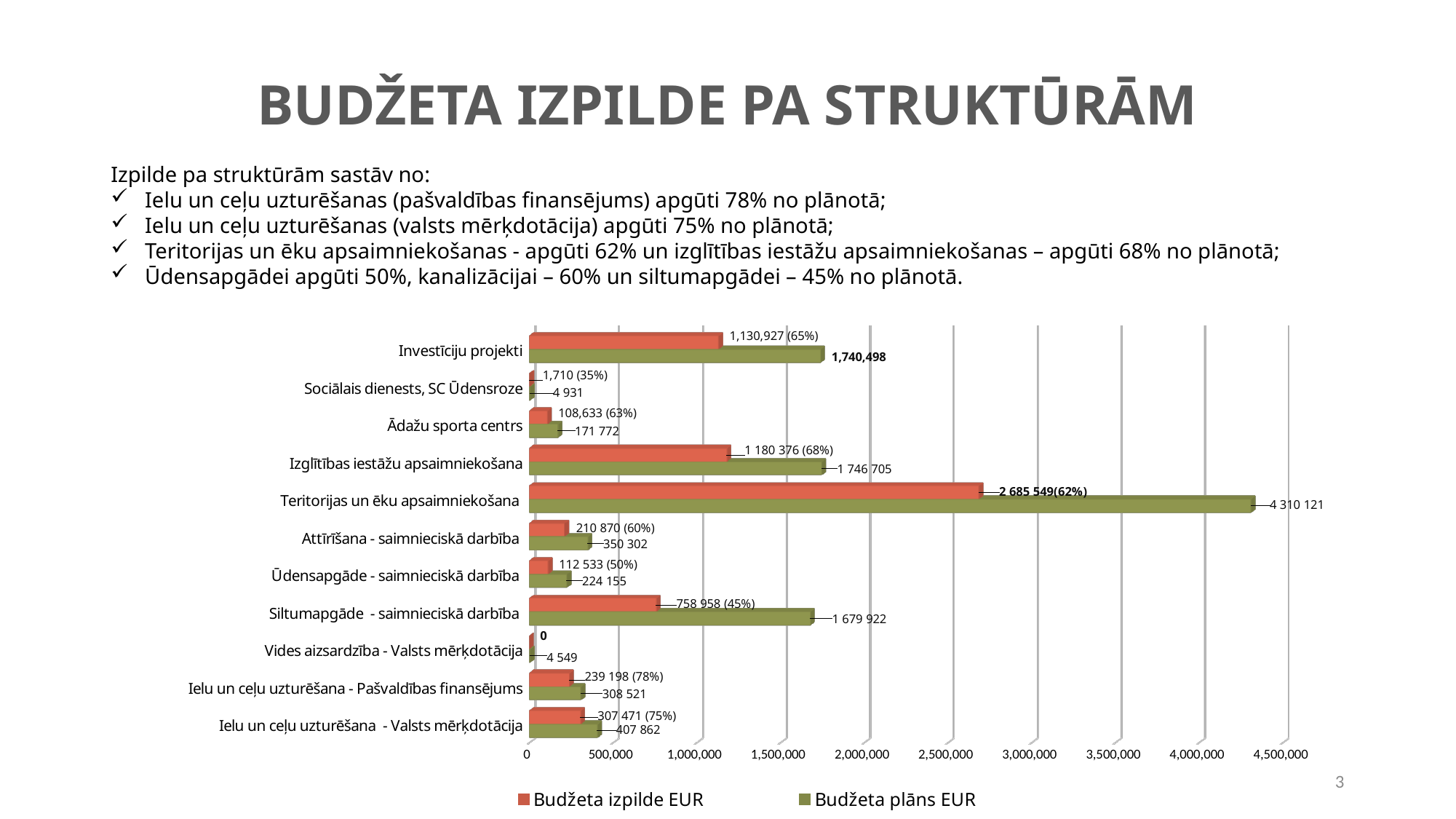
What is the Budžeta izpilde EUR value for Vides aizsardzība - Valsts mērķdotācija? 0 How many categories are shown on the chart? 11 Which is larger: the Budžeta izpilde EUR value for Izglītības iestāžu apsaimniekošana or for Investīciju projekti? Izglītības iestāžu apsaimniekošana What type of chart is shown on the slide? bar chart Is the Budžeta plāns EUR value for Attīrīšana - saimnieciskā darbība greater or less than 500,000? less What is the Budžeta plāns EUR value for Teritorijas un ēku apsaimniekošana? 4 310 121 Which category has the lowest Budžeta izpilde EUR value? Vides aizsardzība - Valsts mērķdotācija What is the Budžeta plāns EUR value for Investīciju projekti? 1,740,498 How many series does the chart legend list? 2 What is the Budžeta izpilde EUR value for Siltumapgāde - saimnieciskā darbība? 758 958 Which category has the highest Budžeta plāns EUR value? Teritorijas un ēku apsaimniekošana What is the difference between the Budžeta plāns EUR and Budžeta izpilde EUR values for Siltumapgāde - saimnieciskā darbība? 920 964